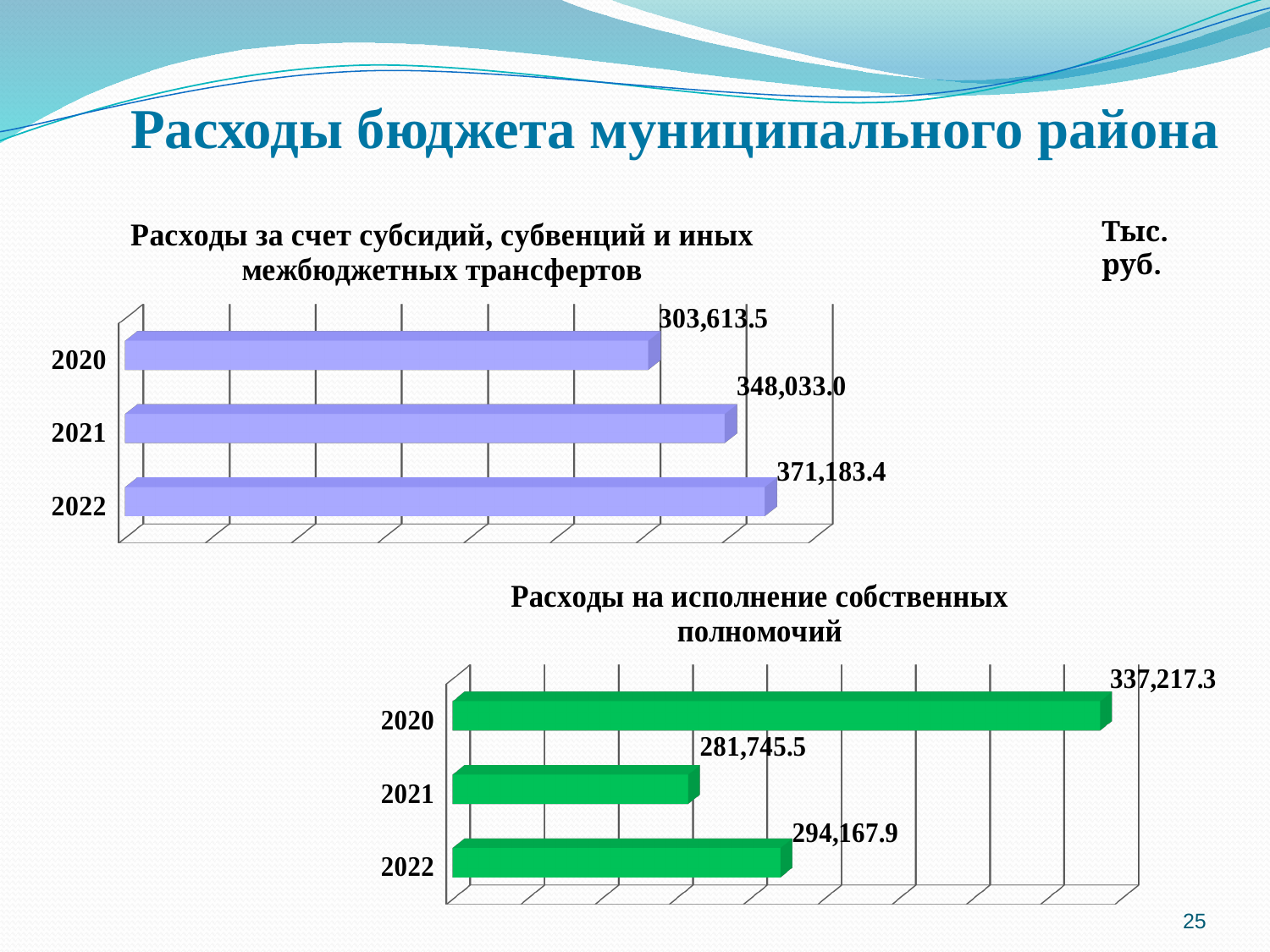
In the top chart (Расходы за счет субсидий, субвенций и иных межбюджетных трансфертов), what is the value for 2020? 303,613.5 In the bottom chart (Расходы на исполнение собственных полномочий), what is the difference between the 2020 and 2021 values? 55,471.8 In the top chart (Расходы за счет субсидий, субвенций и иных межбюджетных трансфертов), do the values rise or fall from 2020 to 2022? Rise In the top chart (Расходы за счет субсидий, субвенций и иных межбюджетных трансфертов), what is the value for 2021? 348,033.0 In the bottom chart (Расходы на исполнение собственных полномочий), which is larger: the value for 2021 or the value for 2022? 2022 In the top chart (Расходы за счет субсидий, субвенций и иных межбюджетных трансфертов), which year has the lowest value? 2020 In the top chart (Расходы за счет субсидий, субвенций и иных межбюджетных трансфертов), what is the difference between the 2022 and 2020 values? 67,569.9 In the bottom chart (Расходы на исполнение собственных полномочий), which year has the highest value? 2020 In the bottom chart (Расходы на исполнение собственных полномочий), what is the value for 2022? 294,167.9 In the bottom chart (Расходы на исполнение собственных полномочий), which year has the lowest value? 2021 How many years are shown in the top chart (Расходы за счет субсидий, субвенций и иных межбюджетных трансфертов)? 3 What type of chart is the bottom chart (Расходы на исполнение собственных полномочий)? Bar chart